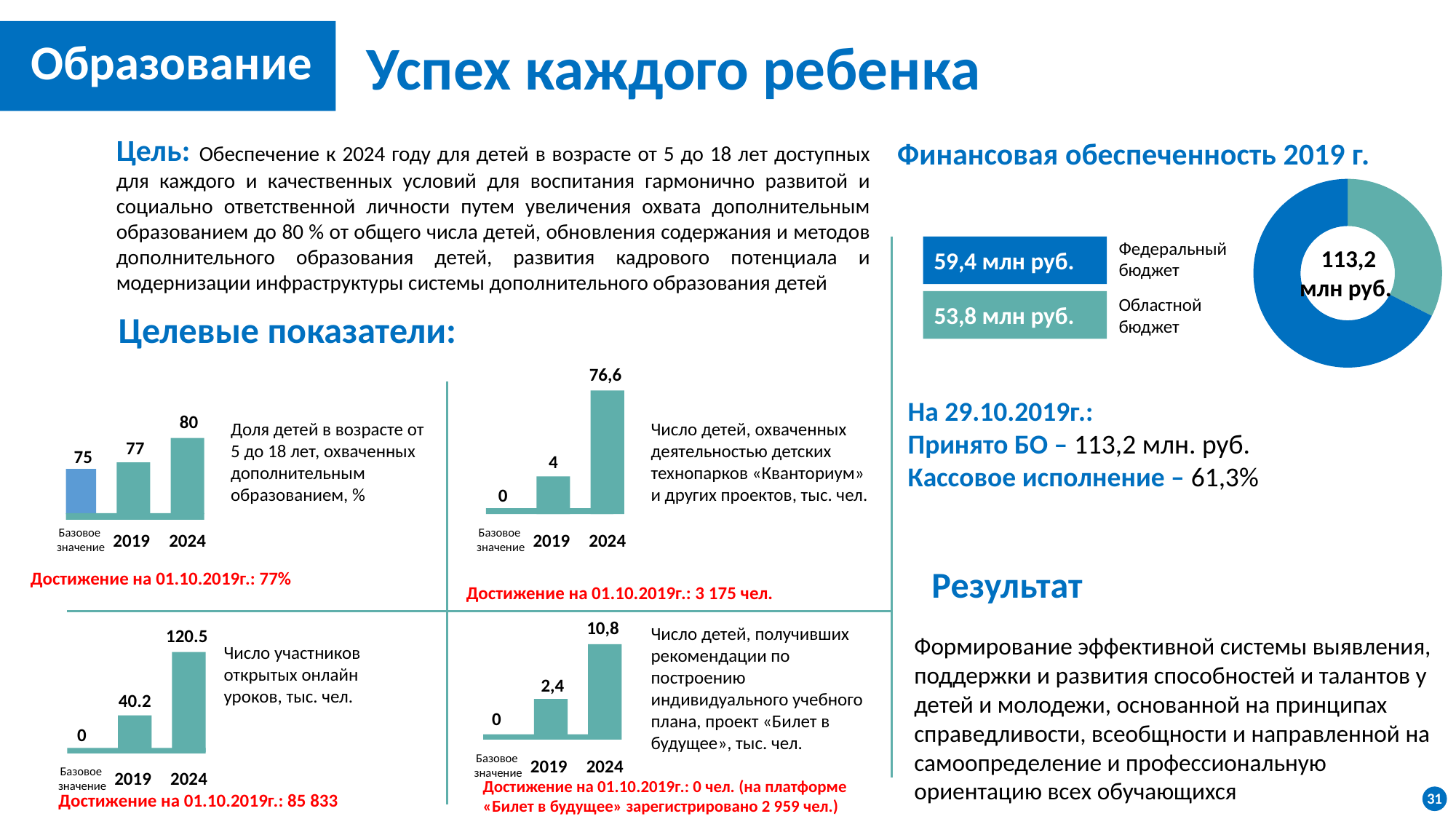
In the bottom-right bar chart (project «Билет в будущее», thousand people), which is larger: the 2019 value or the 2024 value? 2024 In the top-left bar chart (share of children aged 5 to 18 covered by additional education, %), what is the base value (Базовое значение)? 75 In the top-right bar chart (children covered by Kvantorium technoparks and other projects, thousand people), what is the value for 2024? 76,6 In the bottom-left bar chart (participants of open online lessons, thousand people), which category has the highest value? 2024 In the donut chart «Финансовая обеспеченность 2019 г.», what total is shown in the centre? 113,2 млн руб. In the bottom-left bar chart (participants of open online lessons, thousand people), what is the value for 2019? 40.2 In the donut chart «Финансовая обеспеченность 2019 г.», what is the value for the federal budget (Федеральный бюджет)? 59,4 млн руб. In the bottom-right bar chart (children who received recommendations under the «Билет в будущее» project, thousand people), what is the value for 2024? 10,8 In the top-right bar chart (children covered by Kvantorium technoparks and other projects, thousand people), what is the value for 2019? 4 In the top-left bar chart (share of children covered by additional education, %), what is the difference between the 2024 value and the base value? 5 In the top-left bar chart (share of children aged 5 to 18 covered by additional education, %), what is the value for 2024? 80